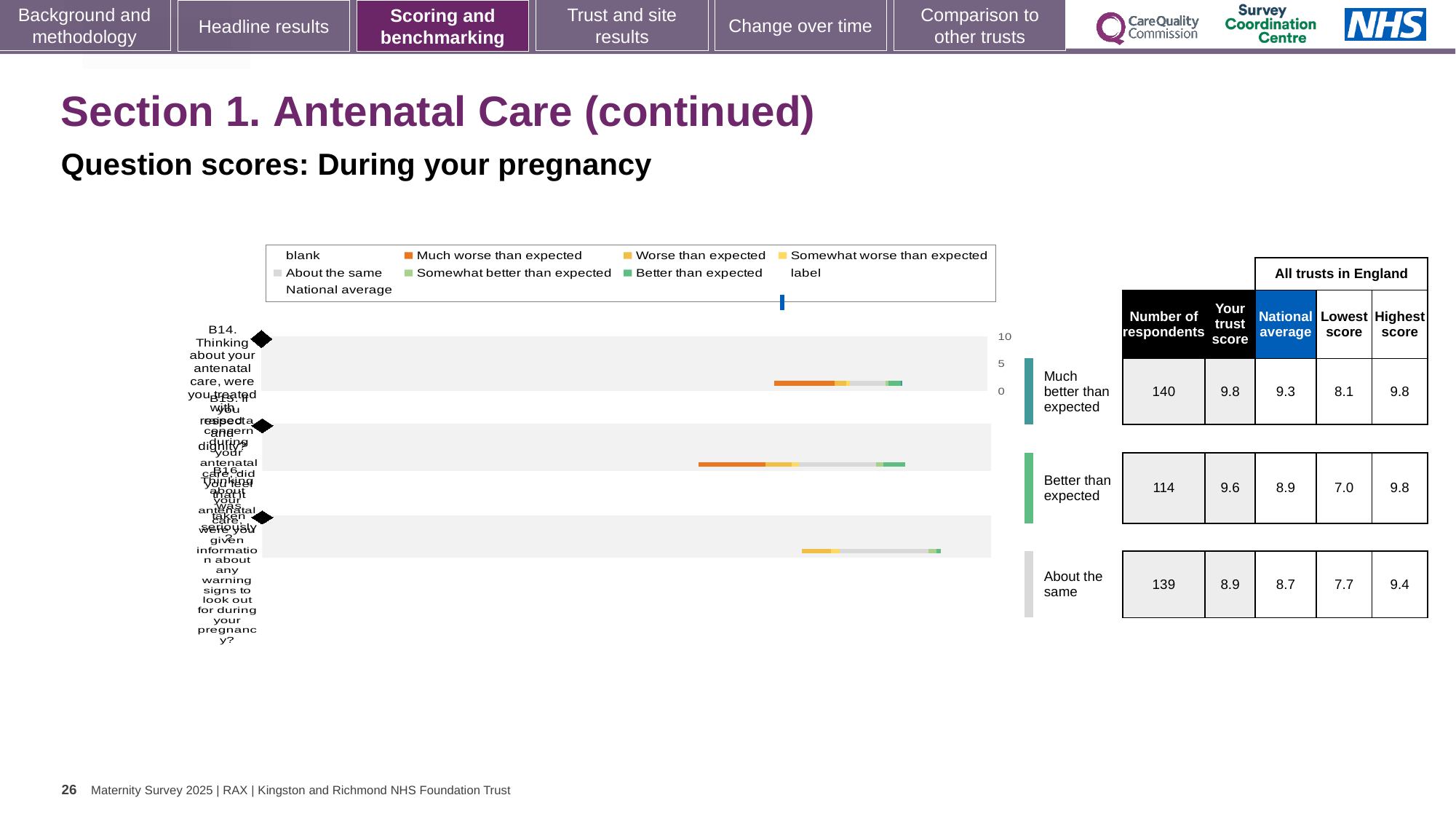
In the table beside the chart, which row has the highest 'Your trust score'? Much better than expected How many horizontal bars are plotted in the chart? 3 In the table beside the chart, what is 'Your trust score' for the 'Better than expected' row? 9.6 In the table beside the chart, what is the 'Highest score' for the 'About the same' row? 9.4 In the table beside the chart, what is the 'National average' for the 'Better than expected' row? 8.9 What kind of chart is shown on the slide? Bar chart In the table beside the chart, what is the difference between 'Your trust score' and 'National average' for the 'Much better than expected' row? 0.5 What is the highest tick value shown on the chart's numeric axis? 10 In the table beside the chart, for the 'About the same' row, which is larger: 'Your trust score' or 'National average'? Your trust score What colour does the legend use for 'Much worse than expected'? Orange In the table beside the chart, which row has the lowest 'Lowest score'? Better than expected In the table beside the chart, what is the number of respondents for the 'Much better than expected' row? 140